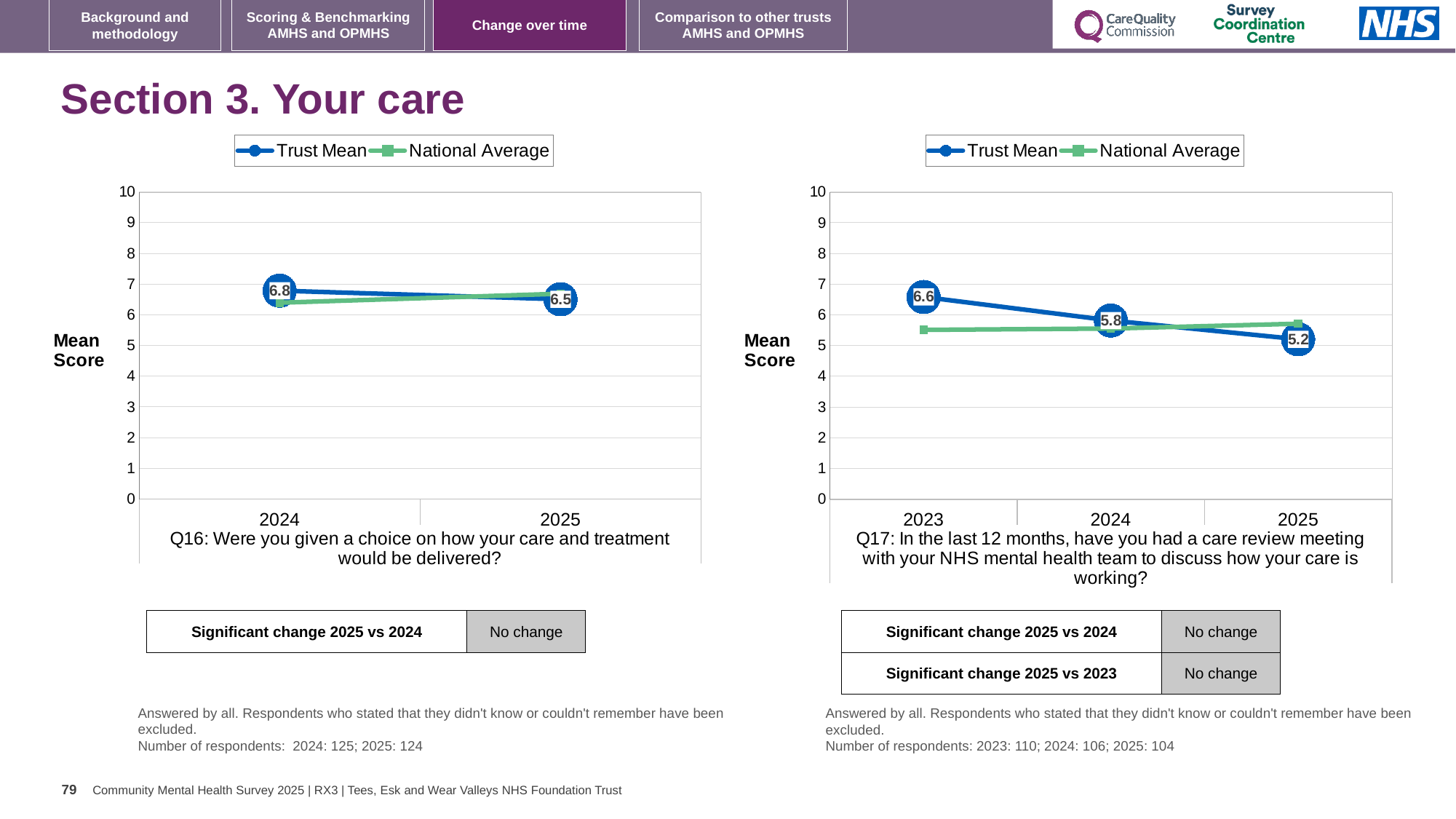
In the Q17 chart, which year has the lowest Trust Mean? 2025 In the Q17 chart, is the National Average for 2025 greater or less than 6? less In the Q17 chart, what is the Trust Mean for 2025? 5.2 In the Q17 chart, does the Trust Mean rise or fall from 2023 to 2025? fall In the Q17 chart, by how much did the Trust Mean fall from 2023 to 2025? 1.4 How many series does the legend of the Q16 chart list? 2 In the Q17 chart, which is larger in 2025, the Trust Mean or the National Average? National Average In the Q17 chart, what is the Trust Mean for 2023? 6.6 In the Q16 chart, what is the Trust Mean for 2024? 6.8 In the Q16 chart, what is the difference between the Trust Mean in 2024 and 2025? 0.3 In the Q16 chart, what is the Trust Mean for 2025? 6.5 In the Q17 chart, which year has the highest Trust Mean? 2023